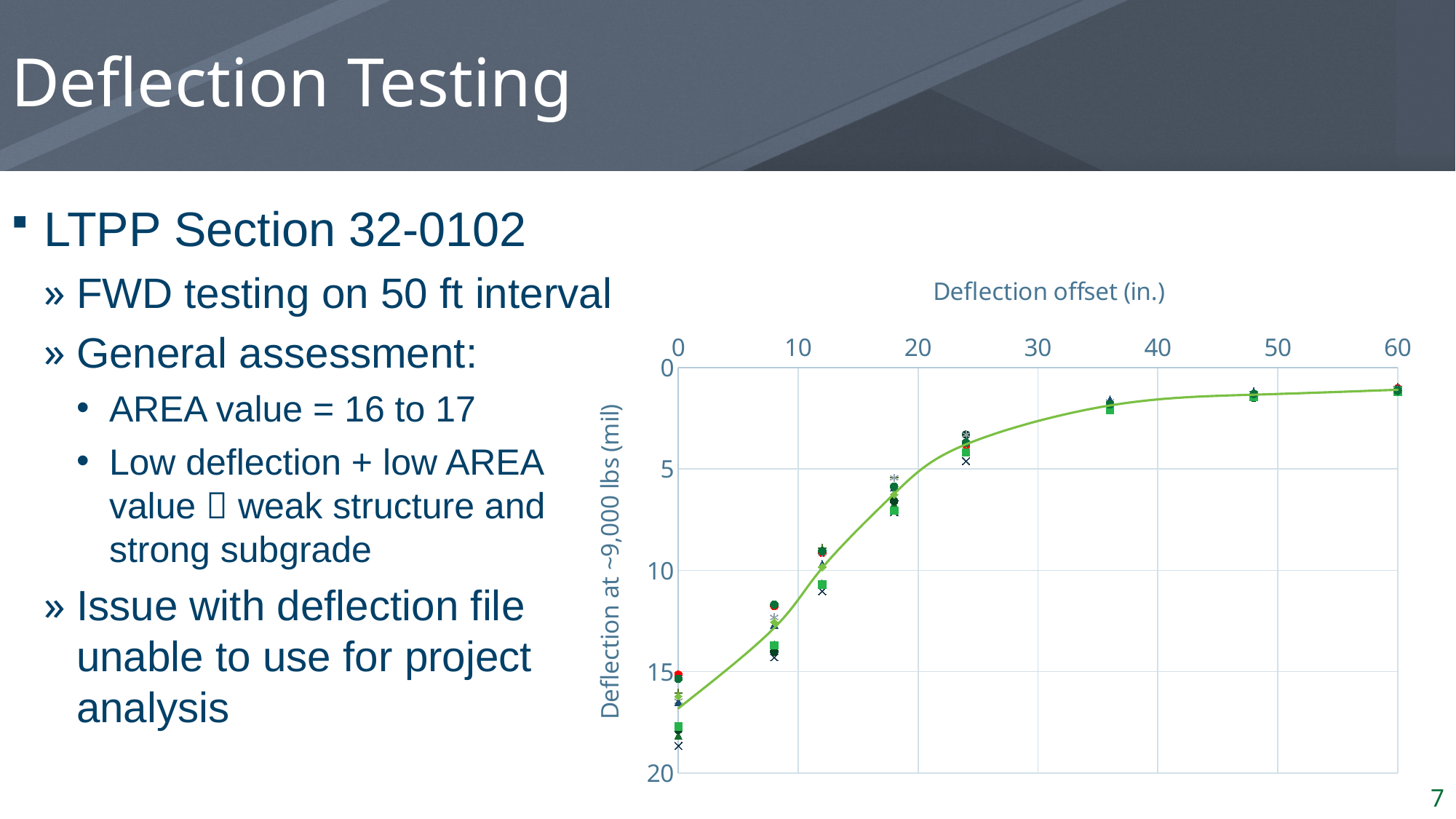
Is the deflection value at an offset of 18 in. greater or less than 10? less At which deflection offset is the deflection highest? 0 How does the deflection change as the deflection offset increases from 0 to 60 in.? it decreases What kind of chart is shown on the slide? scatter chart Is the deflection value at an offset of 0 in. greater or less than 10? greater Is the deflection value at an offset of 60 in. greater or less than 5? less What is the title of the vertical axis of the chart? Deflection at ~9,000 lbs (mil) What is the largest value shown on the horizontal axis of the chart? 60 What is the title of the horizontal axis of the chart? Deflection offset (in.) Which has the larger deflection: offset 0 in. or offset 36 in.? offset 0 in.